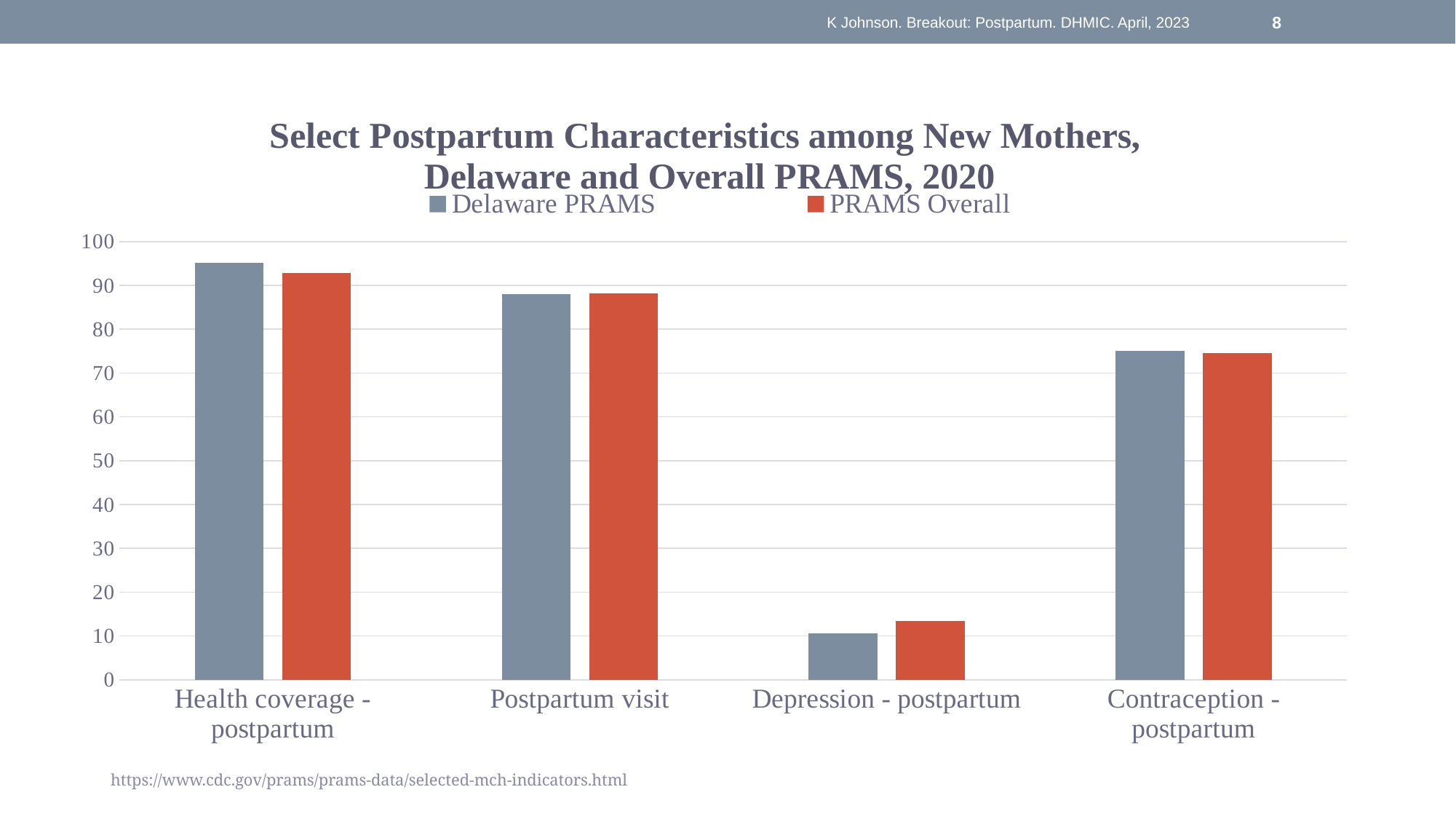
Which series is shown in red in the legend? PRAMS Overall Is the PRAMS Overall value for Depression - postpartum greater or less than 10? greater What is the title of the chart? Select Postpartum Characteristics among New Mothers, Delaware and Overall PRAMS, 2020 Which category has the lowest value for PRAMS Overall? Depression - postpartum Which category has the highest value for Delaware PRAMS? Health coverage - postpartum How many series does the legend list? 2 How many categories are shown on the x axis? 4 Is the Delaware PRAMS value for Contraception - postpartum greater or less than 70? greater For Depression - postpartum, which series has the larger value, Delaware PRAMS or PRAMS Overall? PRAMS Overall Is the Delaware PRAMS value for Health coverage - postpartum greater or less than 90? greater What kind of chart is shown on the slide? bar chart